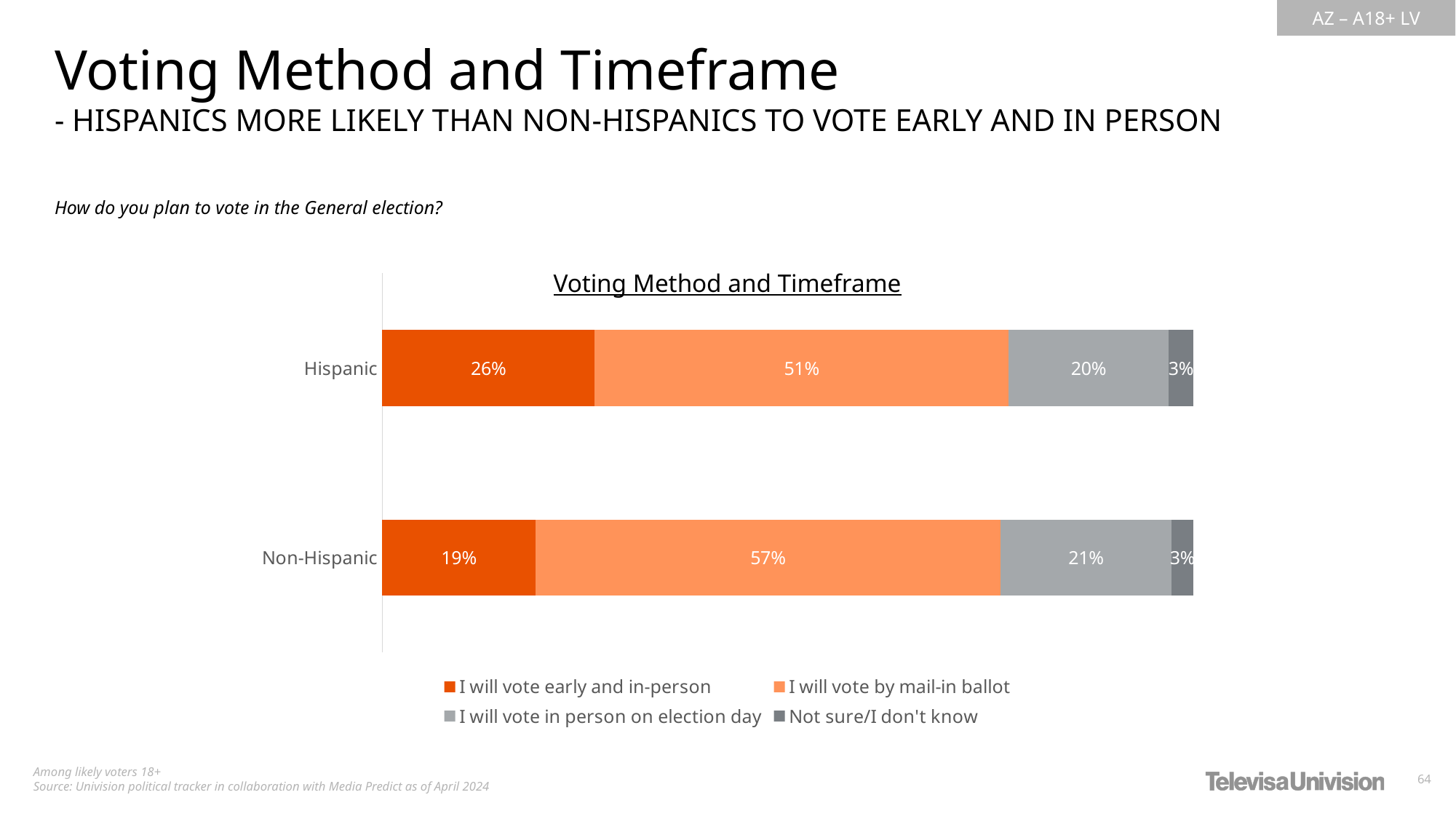
What kind of chart is shown on the slide? Stacked bar chart What percentage of Hispanic respondents say they will vote early and in-person? 26% What percentage of Hispanic respondents say they will vote in person on election day? 20% What is the difference between the Hispanic and Non-Hispanic shares for voting early and in-person? 7 percentage points Which response has the lowest share among Non-Hispanic respondents? Not sure/I don't know What percentage of Non-Hispanic respondents say they will vote by mail-in ballot? 57% Which voting method has the highest share among Hispanic respondents? I will vote by mail-in ballot What is the difference between the Non-Hispanic and Hispanic shares for voting by mail-in ballot? 6 percentage points Which group has the higher share saying they will vote early and in-person, Hispanic or Non-Hispanic? Hispanic What percentage of Non-Hispanic respondents are not sure / don't know how they will vote? 3% How many groups (categories) are shown on the chart? 2 How many series does the legend list? 4